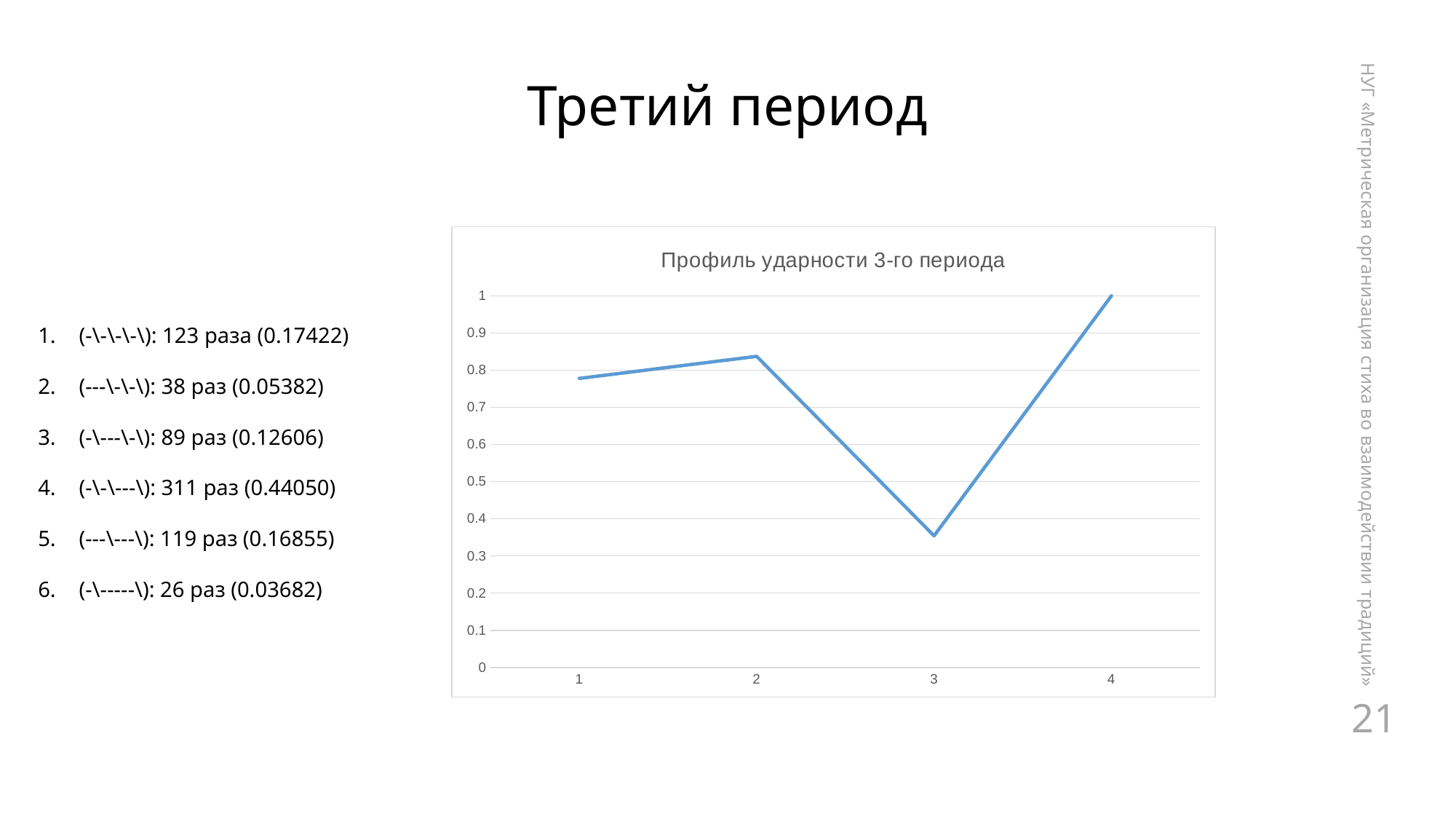
What type of chart is shown on the slide? line chart Is the value at x = 3 greater or less than 0.5? less What is the value at x = 4 in the chart? 1 Does the line rise or fall between x = 3 and x = 4? rise Which is larger, the value at x = 2 or the value at x = 3? x = 2 At which x value is the line highest? 4 Is the value at x = 2 greater or less than 0.9? less At which x value is the line lowest? 3 How many points are plotted on the line in the chart? 4 Is the value at x = 1 greater or less than 0.7? greater What is the highest value shown on the y axis of the chart? 1 What is the title of the chart? Профиль ударности 3-го периода